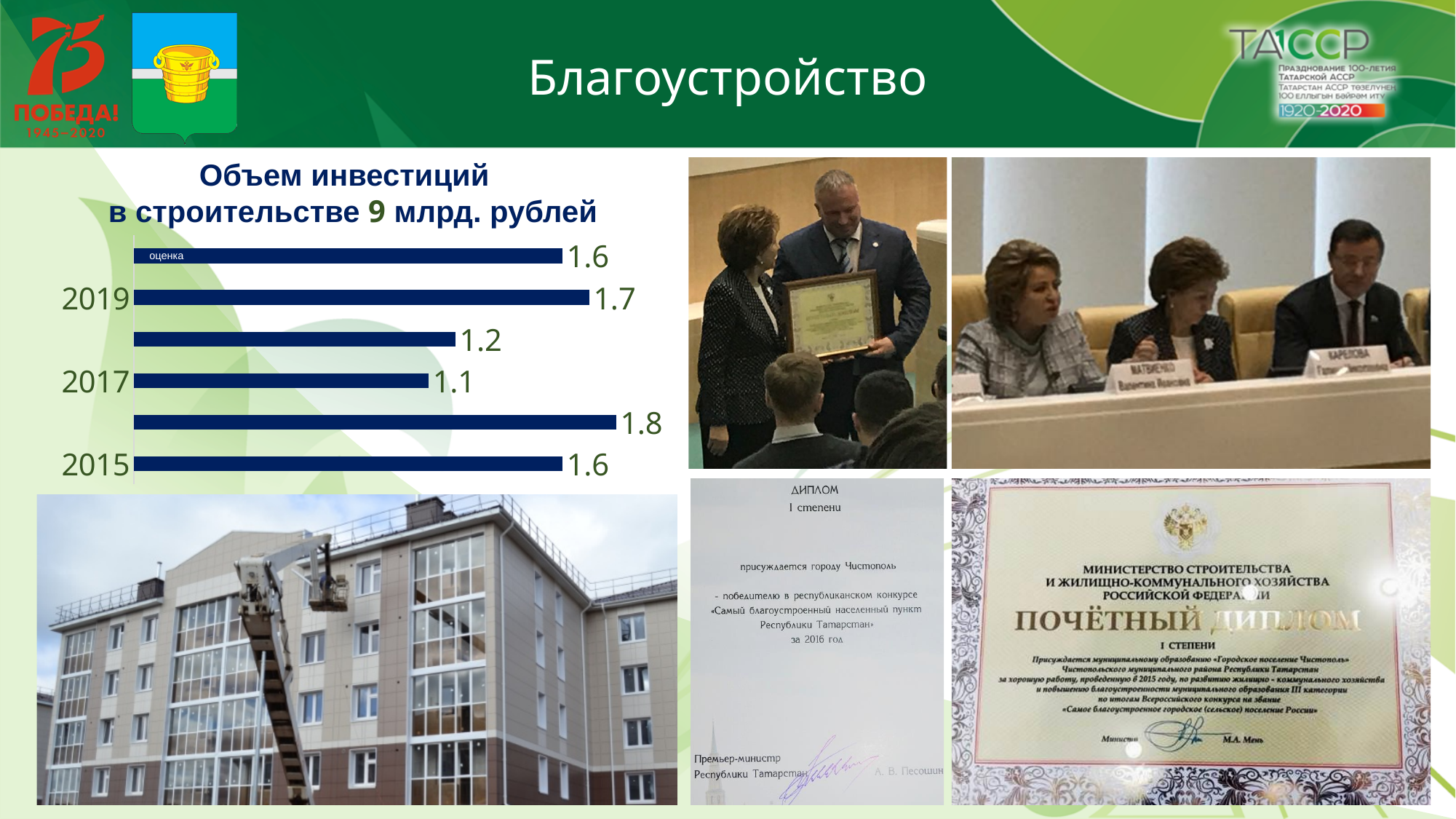
What is the value for 2015 in the chart? 1.6 What is the value for 2019 in the chart? 1.7 What is the value for 2017 in the chart? 1.1 How many bars are shown in the chart? 6 What is the highest value shown in the chart? 1.8 What kind of chart is shown on the slide? bar chart What is the value of the top bar labelled "оценка"? 1.6 Which is larger, the value for 2019 or the value for 2015? 2019 What is the difference between the values for 2019 and 2017? 0.6 From 2017 to 2019, do the values rise or fall? rise Which labelled year has the lowest value in the chart? 2017 What is the title of the chart? Объем инвестиций в строительстве 9 млрд. рублей